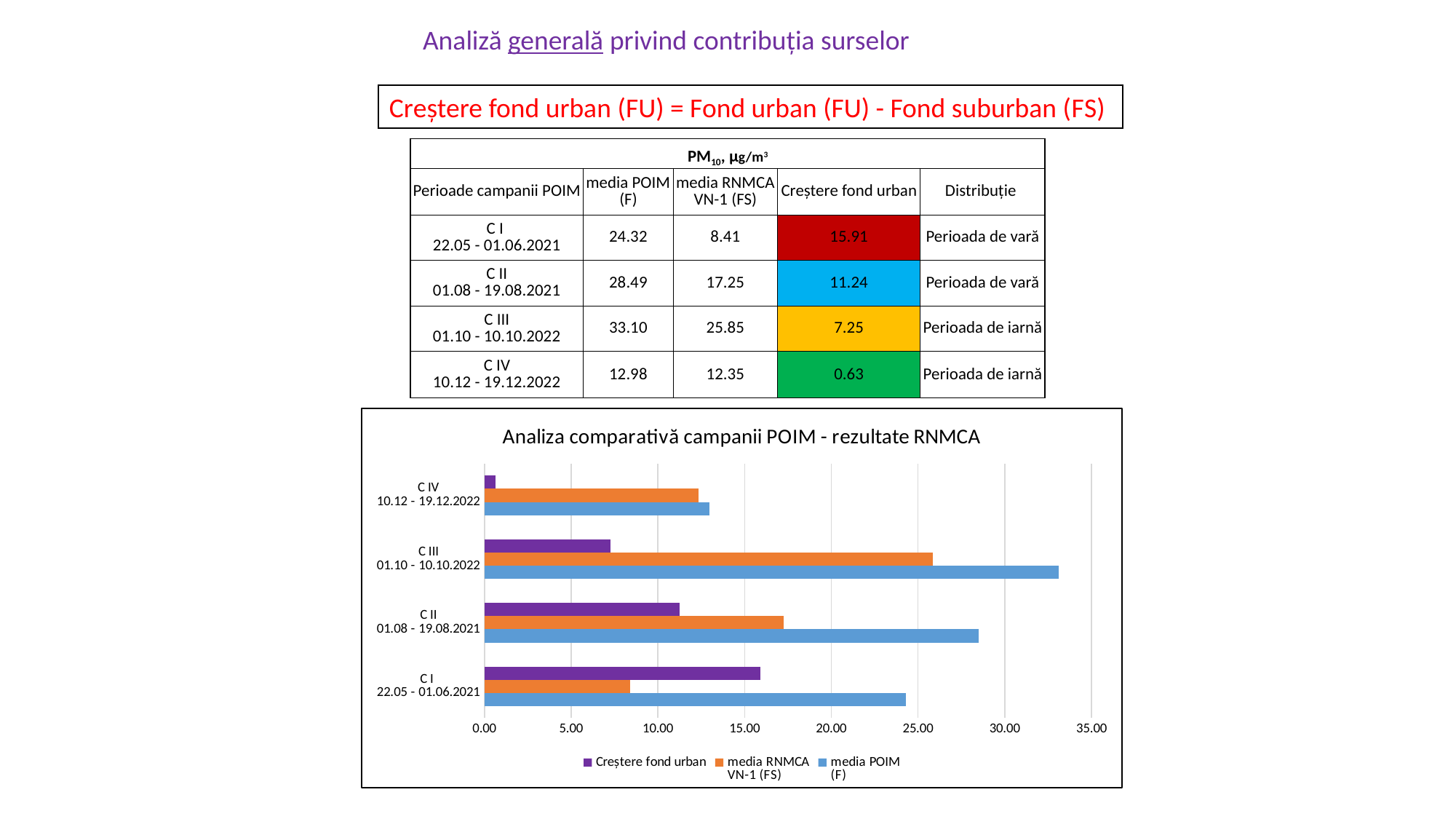
In the bar chart, is the Creștere fond urban value for C I 22.05 - 01.06.2021 greater or less than 10.00? greater In the bar chart, which campaign has the lowest value for Creștere fond urban? C IV 10.12 - 19.12.2022 In the bar chart, which campaign has the highest value for Creștere fond urban? C I 22.05 - 01.06.2021 In the bar chart, is the media RNMCA VN-1 (FS) value for C IV 10.12 - 19.12.2022 greater or less than 15.00? less What colour are the bars for the Creștere fond urban series in the bar chart? purple In the bar chart, for C IV 10.12 - 19.12.2022, which is larger: media RNMCA VN-1 (FS) or Creștere fond urban? media RNMCA VN-1 (FS) In the bar chart, which campaign has the highest value for media POIM (F)? C III 01.10 - 10.10.2022 How many series does the legend of the bar chart list? 3 In the bar chart, is the media POIM (F) value for C III 01.10 - 10.10.2022 greater or less than 30.00? greater How many campaign periods (categories) are plotted in the bar chart? 4 In the bar chart, for C I 22.05 - 01.06.2021, which is larger: media POIM (F) or media RNMCA VN-1 (FS)? media POIM (F) What kind of chart is shown under the title 'Analiza comparativă campanii POIM - rezultate RNMCA'? bar chart